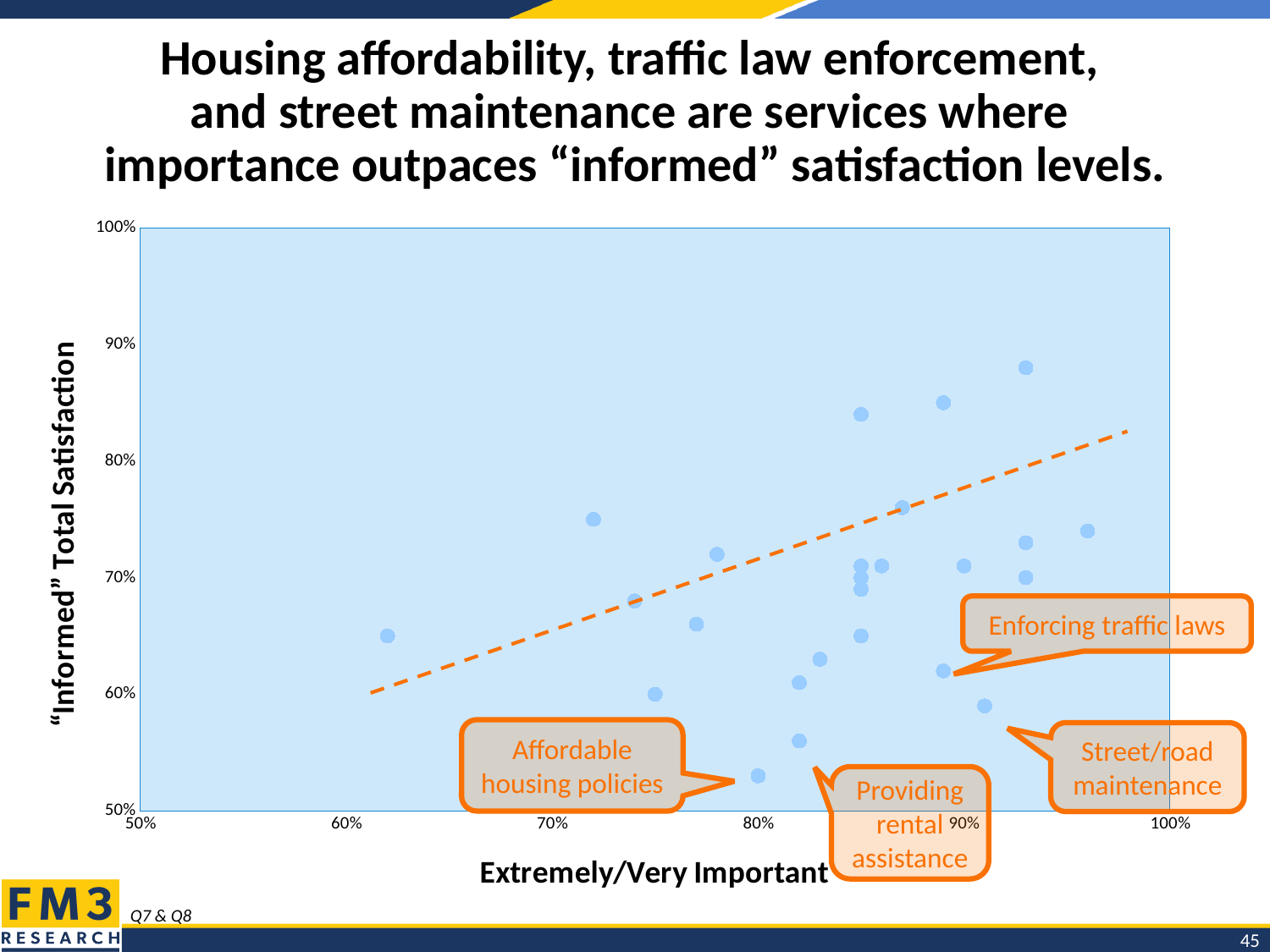
Is the Extremely/Very Important value for Affordable housing policies greater or less than 70%? greater What is the title of the horizontal axis? Extremely/Very Important Is the "Informed" Total Satisfaction value for Affordable housing policies greater or less than 60%? less What is the title of the vertical axis? "Informed" Total Satisfaction Is the Extremely/Very Important value for Enforcing traffic laws greater or less than 80%? greater Does the dashed trend line rise or fall as importance increases along the x axis? Rises Which has the higher "Informed" Total Satisfaction, Affordable housing policies or Enforcing traffic laws? Enforcing traffic laws What kind of chart is shown on the slide? Scatter chart What is the lowest value shown on the vertical axis? 50%